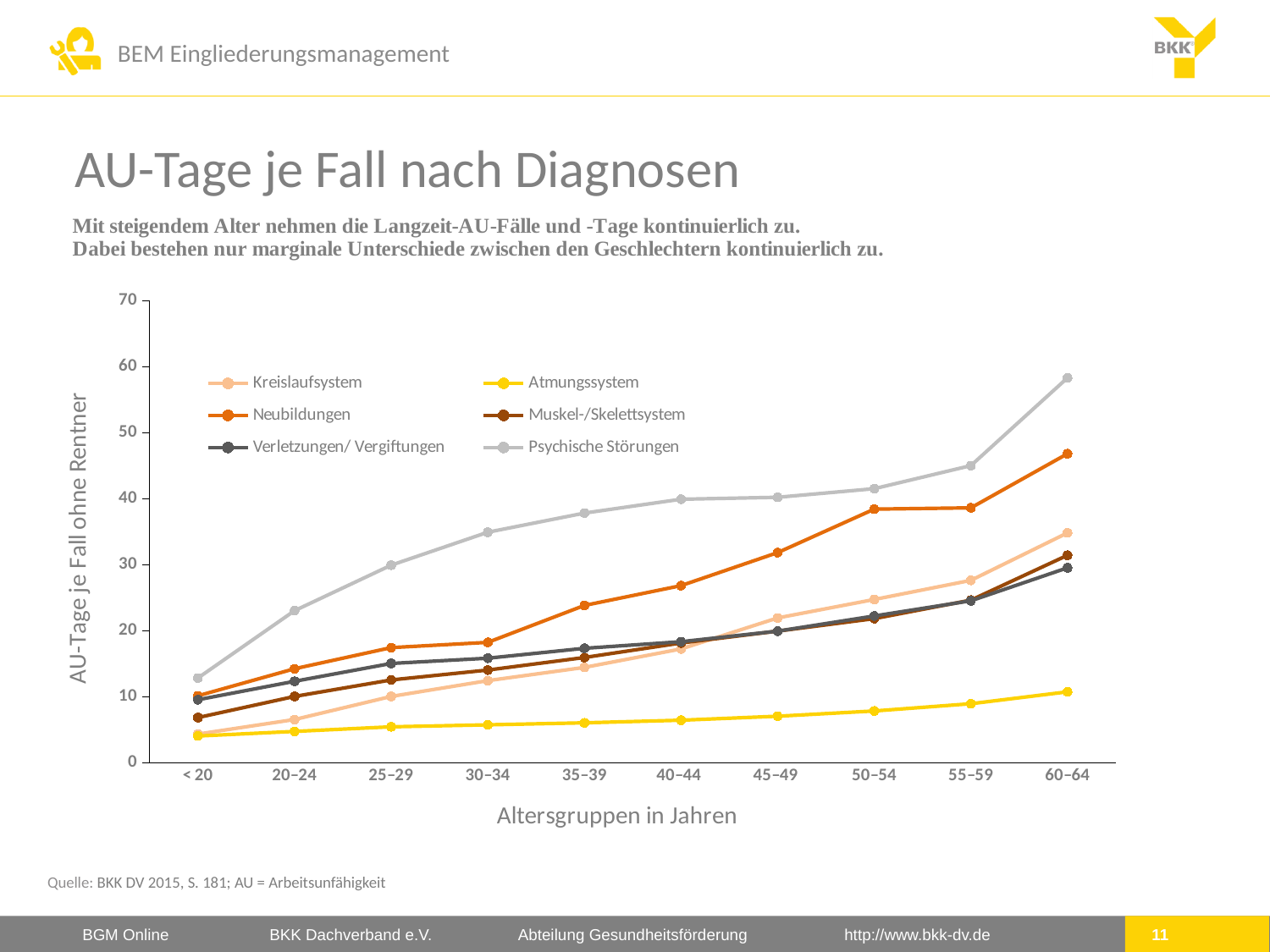
Is the value for Neubildungen in the 60–64 age group greater or less than 40? greater In the 45–49 age group, which is larger: Neubildungen or Kreislaufsystem? Neubildungen How many age groups are shown on the x axis? 10 Do the values for Psychische Störungen rise or fall as the age groups increase? rise What is the title of the y axis? AU-Tage je Fall ohne Rentner What kind of chart is shown on the slide? line chart Is the value for Psychische Störungen in the 60–64 age group greater or less than 50? greater Which series has the highest value in the 60–64 age group? Psychische Störungen Is the value for Psychische Störungen in the < 20 age group greater or less than 20? less How many series does the legend list? 6 Which series has the lowest value in the 60–64 age group? Atmungssystem